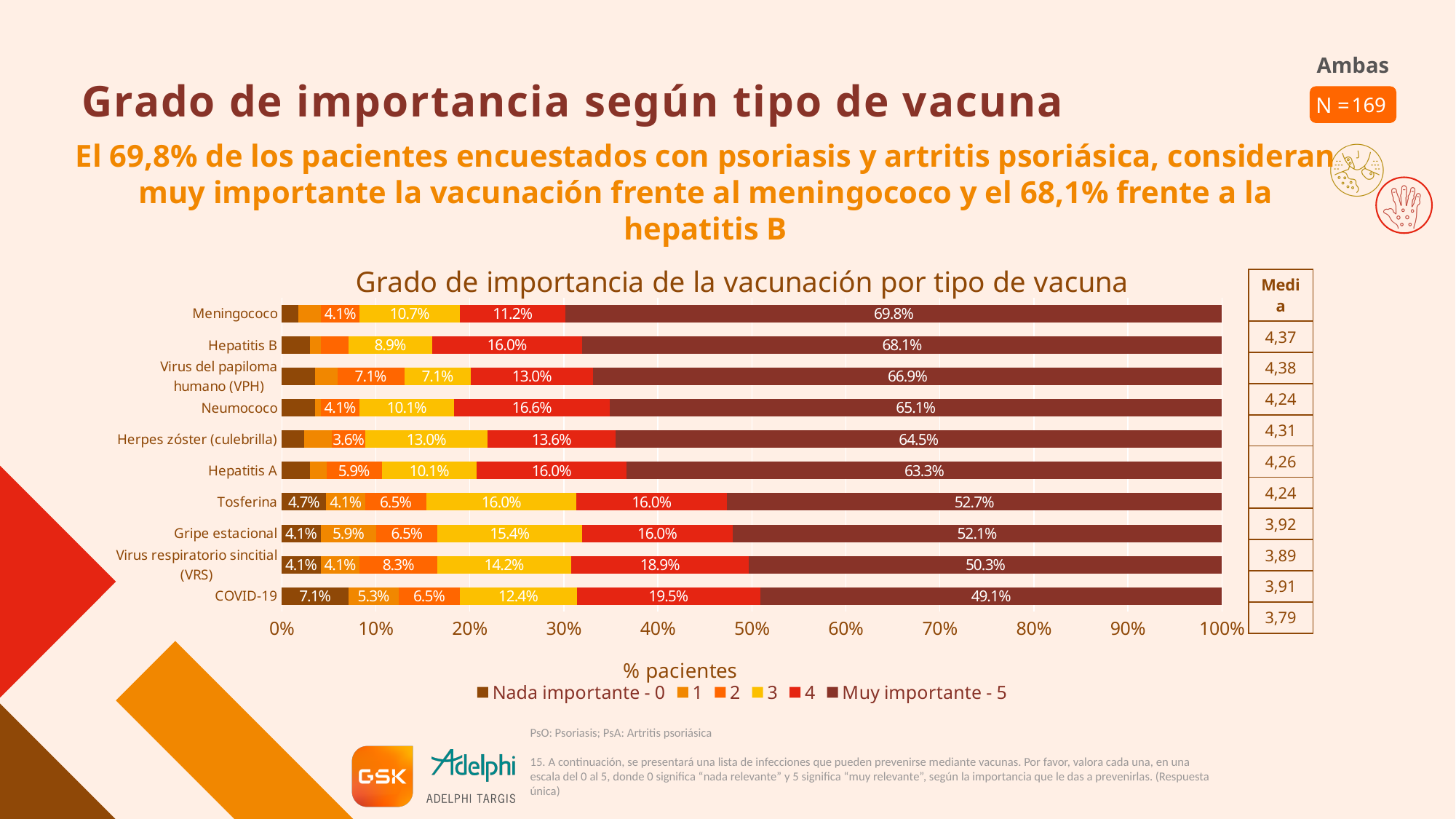
How many vaccine types (categories) are plotted in the chart? 10 Which vaccine has the lowest 'Muy importante - 5' percentage? COVID-19 What is the title of the chart? Grado de importancia de la vacunación por tipo de vacuna What is the difference in percentage points between the 'Muy importante - 5' values for Meningococo and Hepatitis B? 1.7 What percentage of patients gave a rating of 4 to Virus respiratorio sincitial (VRS)? 18.9% Which has a larger 'Muy importante - 5' percentage, Tosferina or Gripe estacional? Tosferina How many series does the chart legend list? 6 Which vaccine has the highest 'Muy importante - 5' percentage? Meningococo What kind of chart is shown on the slide? Stacked bar chart What percentage of patients rated Meningococo as 'Muy importante - 5'? 69.8% What percentage of patients rated COVID-19 as 'Muy importante - 5'? 49.1% What percentage of patients rated COVID-19 as 'Nada importante - 0'? 7.1%